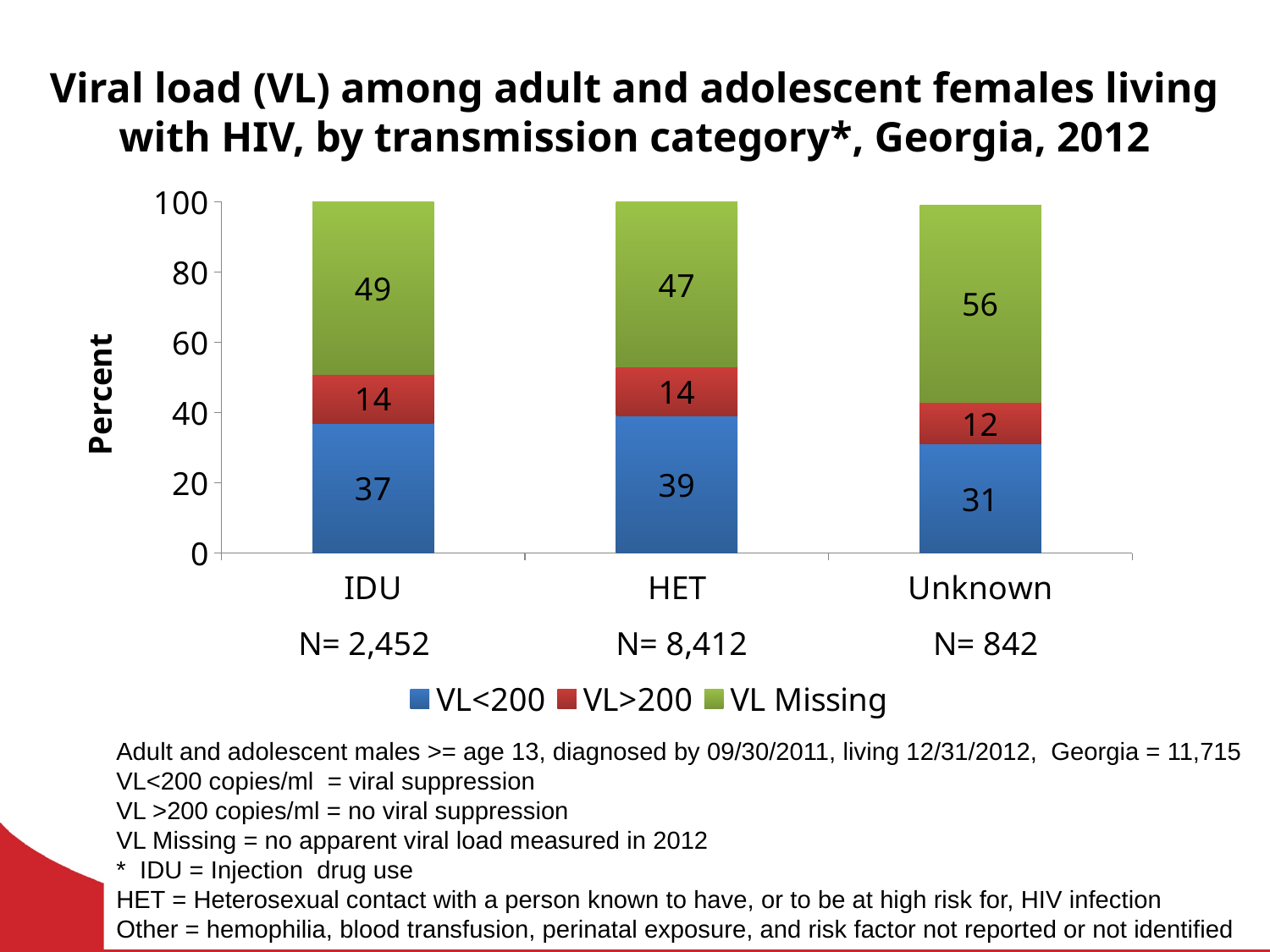
How many series does the legend list? 3 What is the label of the y axis? Percent Which transmission category has the lowest VL>200 value? Unknown Which is larger, the VL<200 value for IDU or for Unknown? IDU What is the difference between the VL Missing values for Unknown and HET? 9 What kind of chart is shown? Stacked bar chart How many transmission categories are shown on the x axis? 3 What is the VL<200 value for IDU? 37 What is the VL>200 value for HET? 14 What is the total of the stacked bar for Unknown? 99 Which transmission category has the highest VL<200 value? HET What is the VL Missing value for Unknown? 56